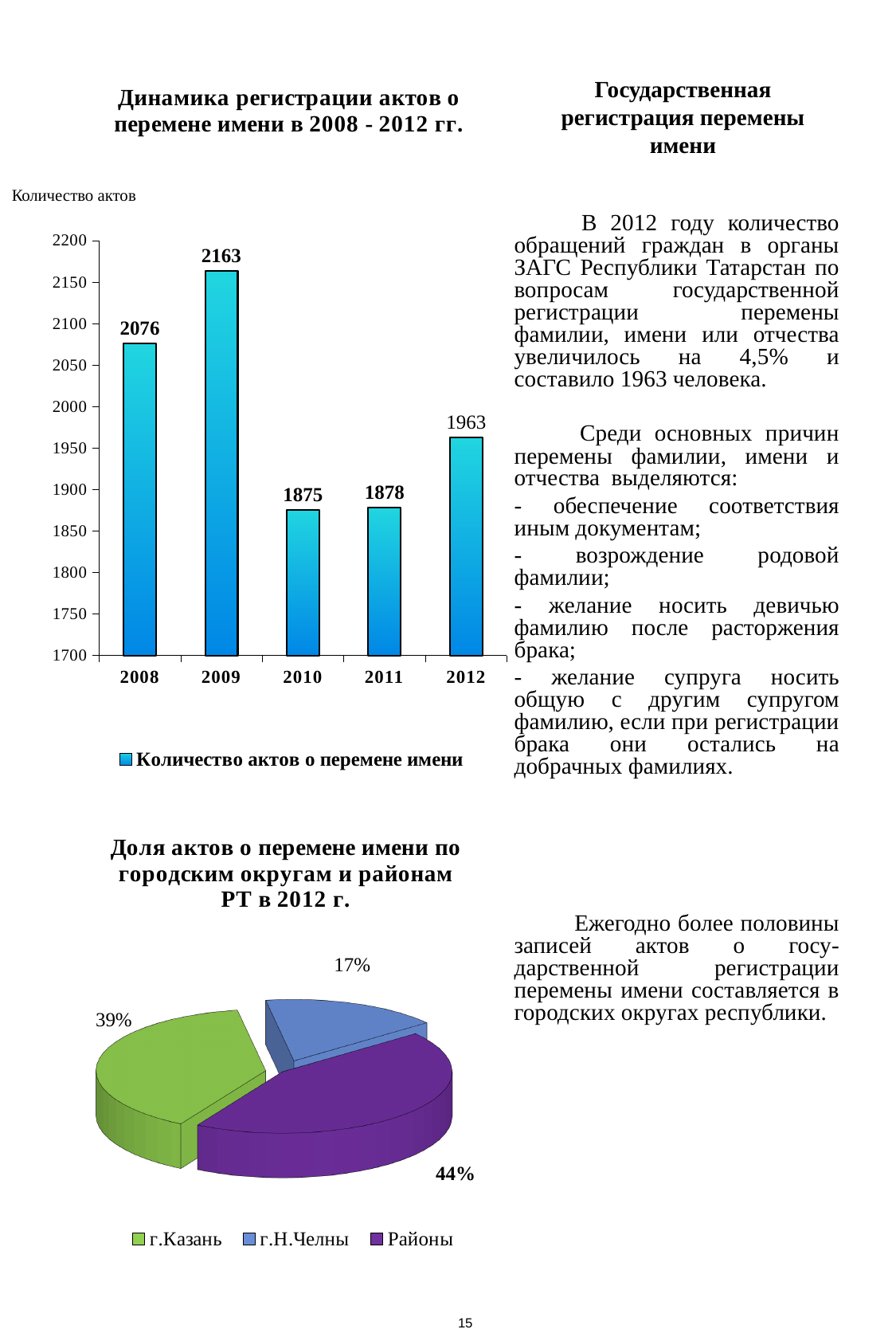
What kind of chart is 'Динамика регистрации актов о перемене имени в 2008 - 2012 гг.'? bar chart In the bar chart 'Динамика регистрации актов о перемене имени в 2008 - 2012 гг.', what is the value for 2012? 1963 In the bar chart 'Динамика регистрации актов о перемене имени в 2008 - 2012 гг.', what is the value for 2009? 2163 In the pie chart 'Доля актов о перемене имени по городским округам и районам РТ в 2012 г.', which is larger: the share for Районы or the share for г.Казань? Районы In the bar chart 'Динамика регистрации актов о перемене имени в 2008 - 2012 гг.', which year has the highest value? 2009 In the bar chart 'Динамика регистрации актов о перемене имени в 2008 - 2012 гг.', how many years are shown? 5 In the bar chart 'Динамика регистрации актов о перемене имени в 2008 - 2012 гг.', which year has the lowest value? 2010 In the pie chart 'Доля актов о перемене имени по городским округам и районам РТ в 2012 г.', which category has the smallest share? г.Н.Челны In the bar chart 'Динамика регистрации актов о перемене имени в 2008 - 2012 гг.', is the value for 2012 greater or less than 2000? less In the pie chart 'Доля актов о перемене имени по городским округам и районам РТ в 2012 г.', what share does г.Казань have? 39% In the bar chart 'Динамика регистрации актов о перемене имени в 2008 - 2012 гг.', what is the difference between the values for 2009 and 2008? 87 In the pie chart 'Доля актов о перемене имени по городским округам и районам РТ в 2012 г.', how many categories does the legend list? 3